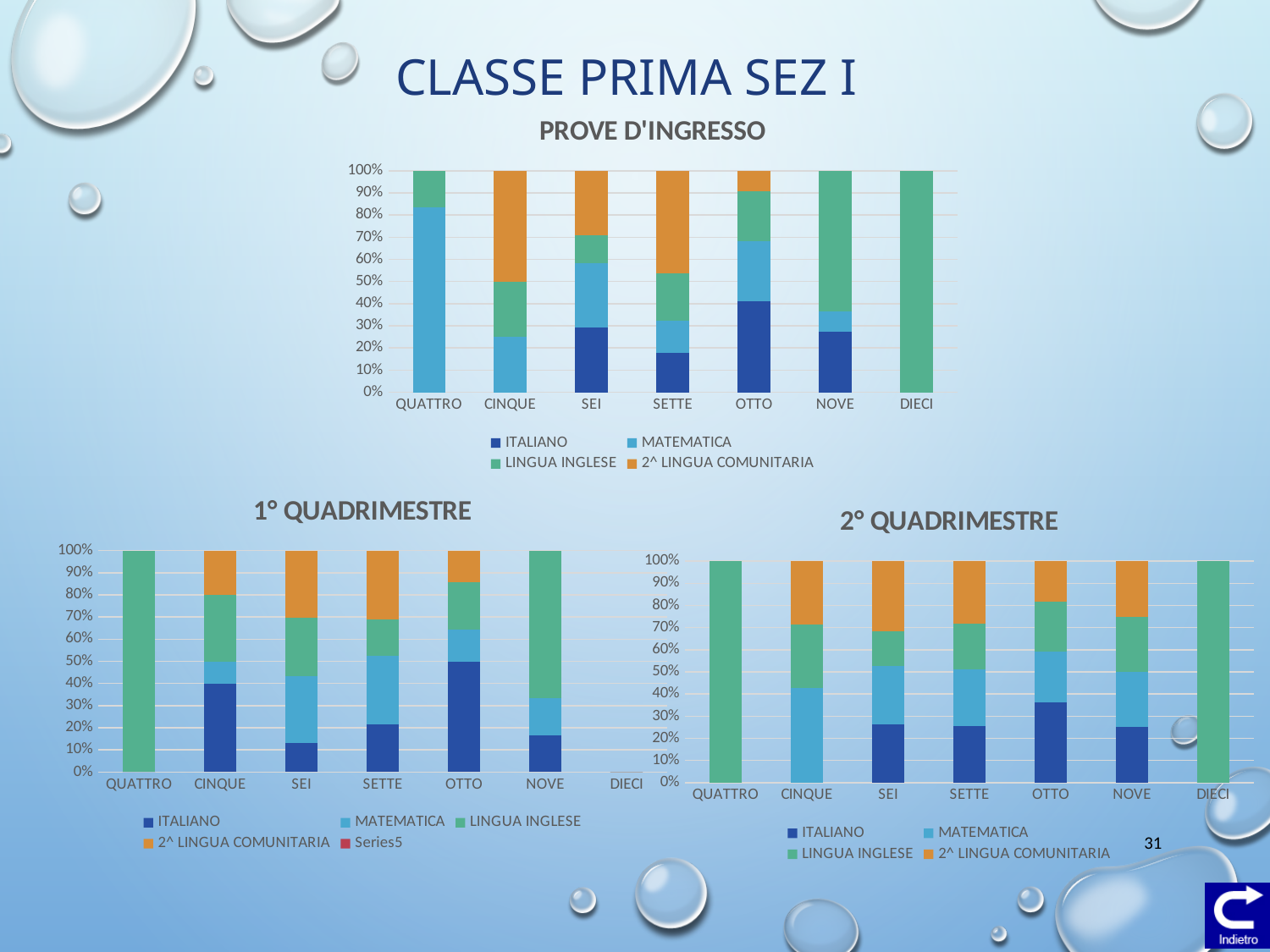
How many categories are shown on the x axis of the PROVE D'INGRESSO chart? 7 In the PROVE D'INGRESSO chart, which category has the largest ITALIANO share? OTTO In the PROVE D'INGRESSO chart, what is the LINGUA INGLESE share for DIECI? 100% In the 1° QUADRIMESTRE chart, what is the LINGUA INGLESE share for QUATTRO? 100% What is the title of the chart at the top of the slide? PROVE D'INGRESSO In the PROVE D'INGRESSO chart, is the ITALIANO value for OTTO greater or less than 30%? greater In the 1° QUADRIMESTRE chart, is the ITALIANO value for SEI greater or less than 20%? less What kind of chart is the PROVE D'INGRESSO chart? Stacked bar chart In the 2° QUADRIMESTRE chart, is the MATEMATICA value for CINQUE greater or less than 30%? greater In the 1° QUADRIMESTRE chart, which is larger: the ITALIANO share for OTTO or for CINQUE? OTTO How many series does the legend of the 1° QUADRIMESTRE chart list? 5 How many series does the legend of the 2° QUADRIMESTRE chart list? 4